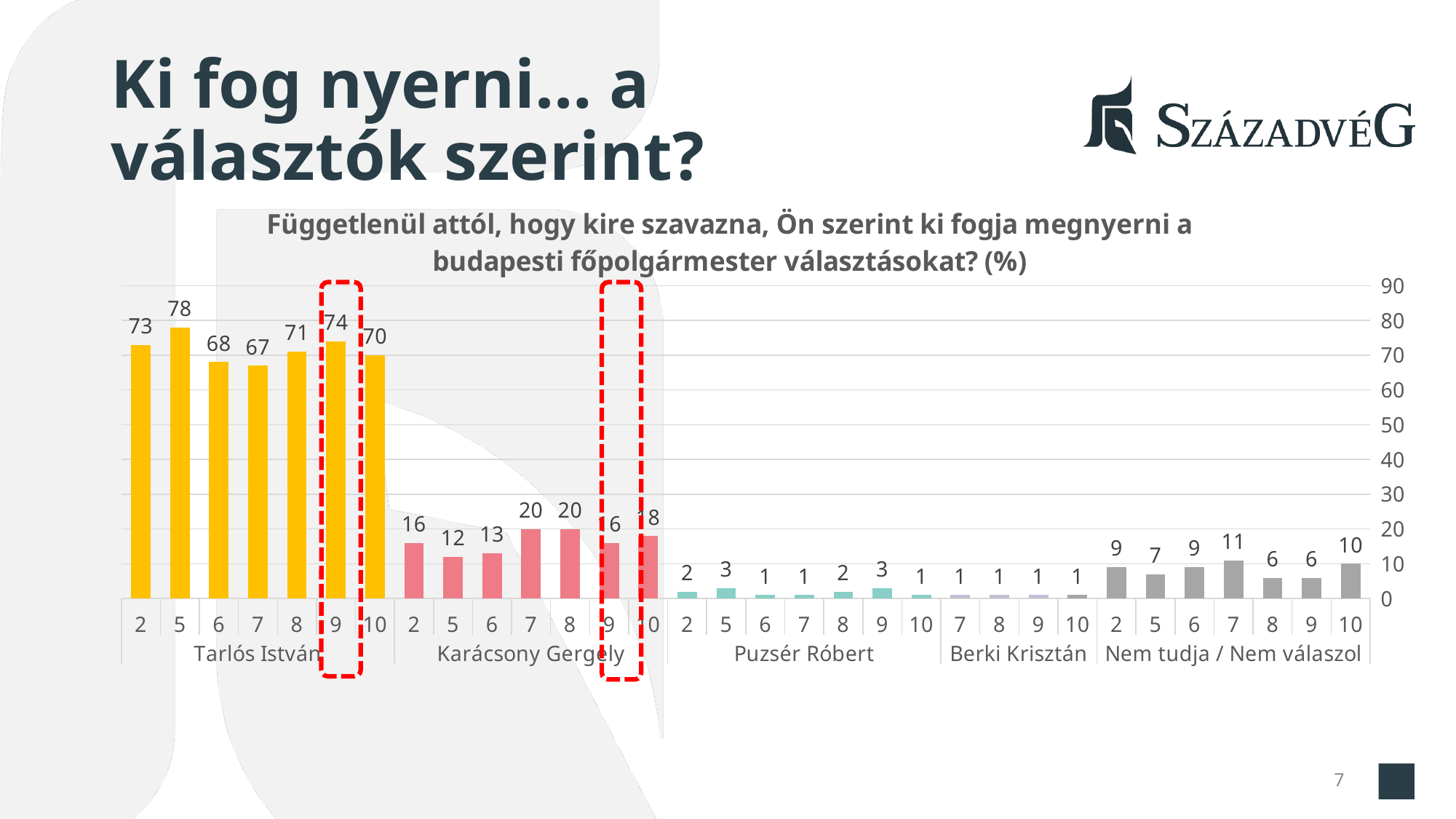
What is the value for Karácsony Gergely in month 10? 18 Which is larger: Karácsony Gergely's value in month 7 or in month 5? month 7 In which month does Tarlós István have the lowest value? 7 What is the value for Tarlós István in month 5? 78 How many candidate/answer groups are shown along the x axis? 5 What kind of chart is shown on the slide? bar chart What is the difference between Tarlós István's value in month 9 and Karácsony Gergely's value in month 9? 58 Do Tarlós István's values rise or fall from month 2 to month 5? rise What is the value for Nem tudja / Nem válaszol in month 7? 11 What is the highest value shown on the vertical axis? 90 How many bars are shown for Berki Krisztán? 4 In which month does Tarlós István have the highest value? 5